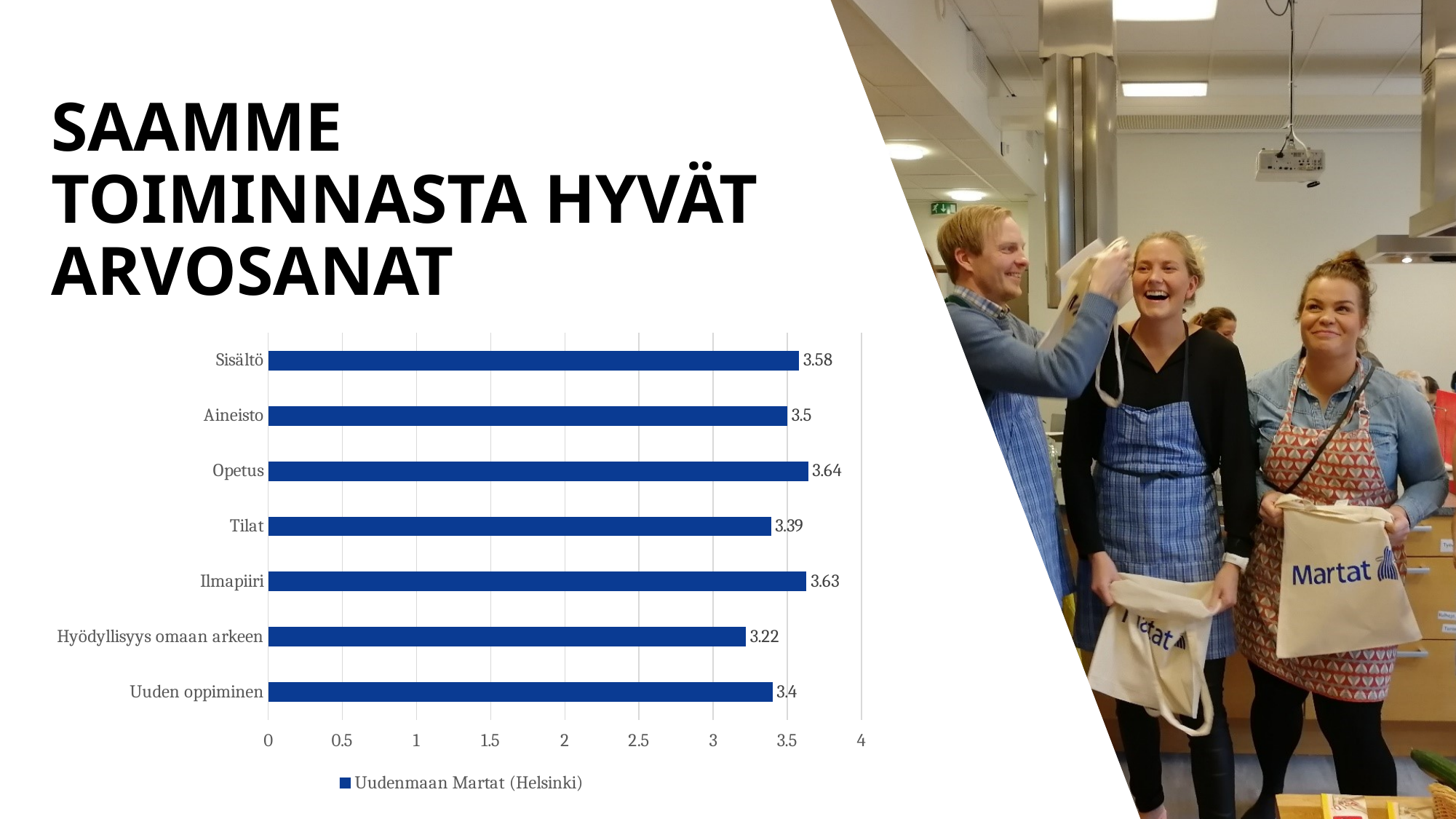
What is the value for Uuden oppiminen? 3.4 Which is larger, the value for Ilmapiiri or the value for Tilat? Ilmapiiri What is the difference between the values for Opetus and Hyödyllisyys omaan arkeen? 0.42 What is the value for Tilat? 3.39 Is the value for Hyödyllisyys omaan arkeen greater or less than 3.5? less How many categories are shown in the chart? 7 Which category has the lowest value? Hyödyllisyys omaan arkeen What kind of chart is shown on the slide? bar chart What is the value for Sisältö? 3.58 Which category has the highest value? Opetus What is the difference between the values for Sisältö and Aineisto? 0.08 What is the value for Hyödyllisyys omaan arkeen? 3.22